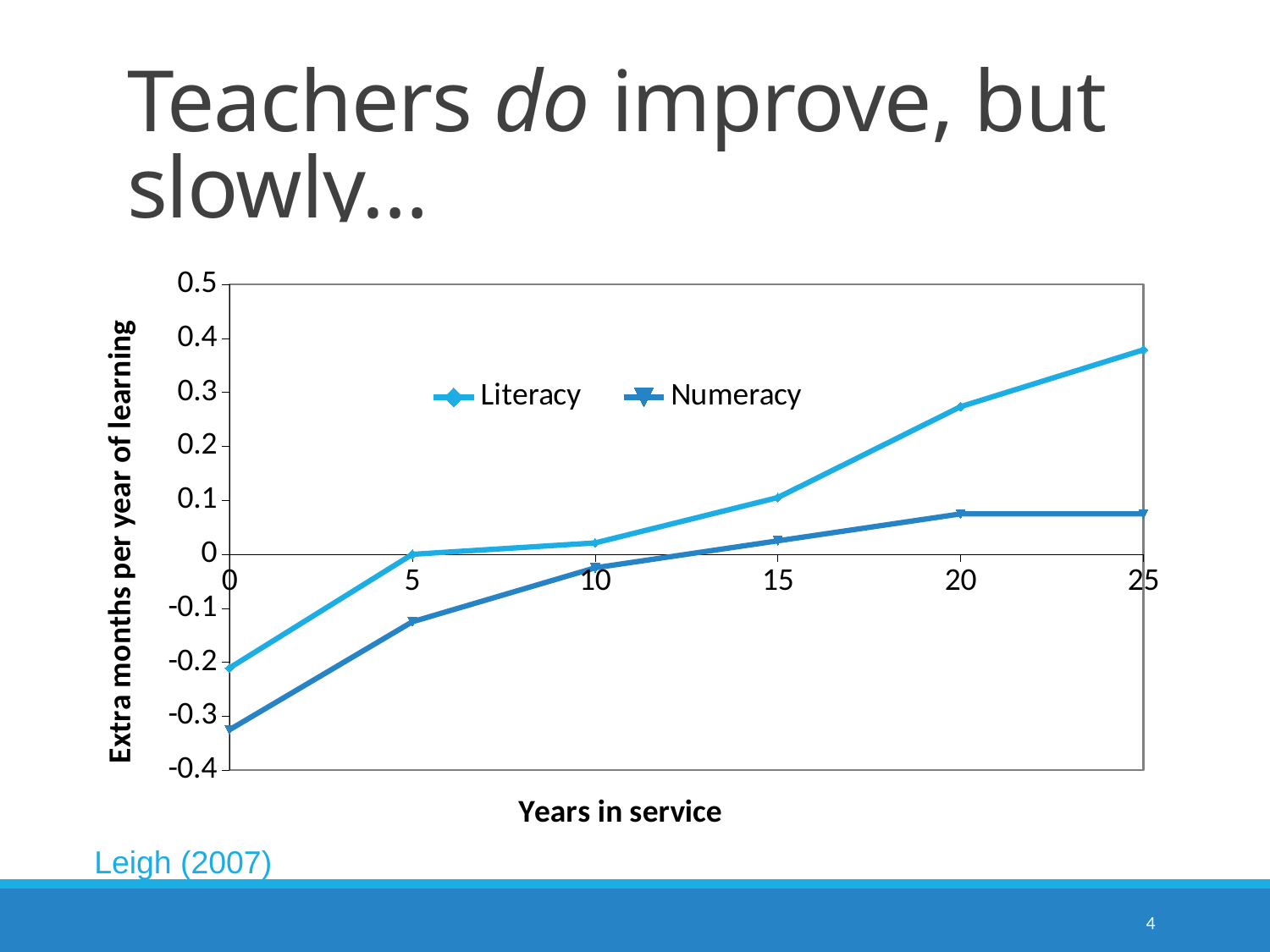
What kind of chart is shown on the slide? line chart Is the Literacy value at 20 years in service greater or less than 0.2? greater At which years in service does the Numeracy series have its lowest value? 0 What is the title of the x axis? Years in service Is the Numeracy value at 0 years in service greater or less than -0.3? less At which years in service does the Literacy series reach its highest value? 25 Is the Numeracy value at 5 years in service greater or less than -0.2? greater Does the Literacy line rise or fall as years in service increase? rise At 25 years in service, which series has the larger value, Literacy or Numeracy? Literacy How many data points are plotted for the Literacy series? 6 How many series does the legend list? 2